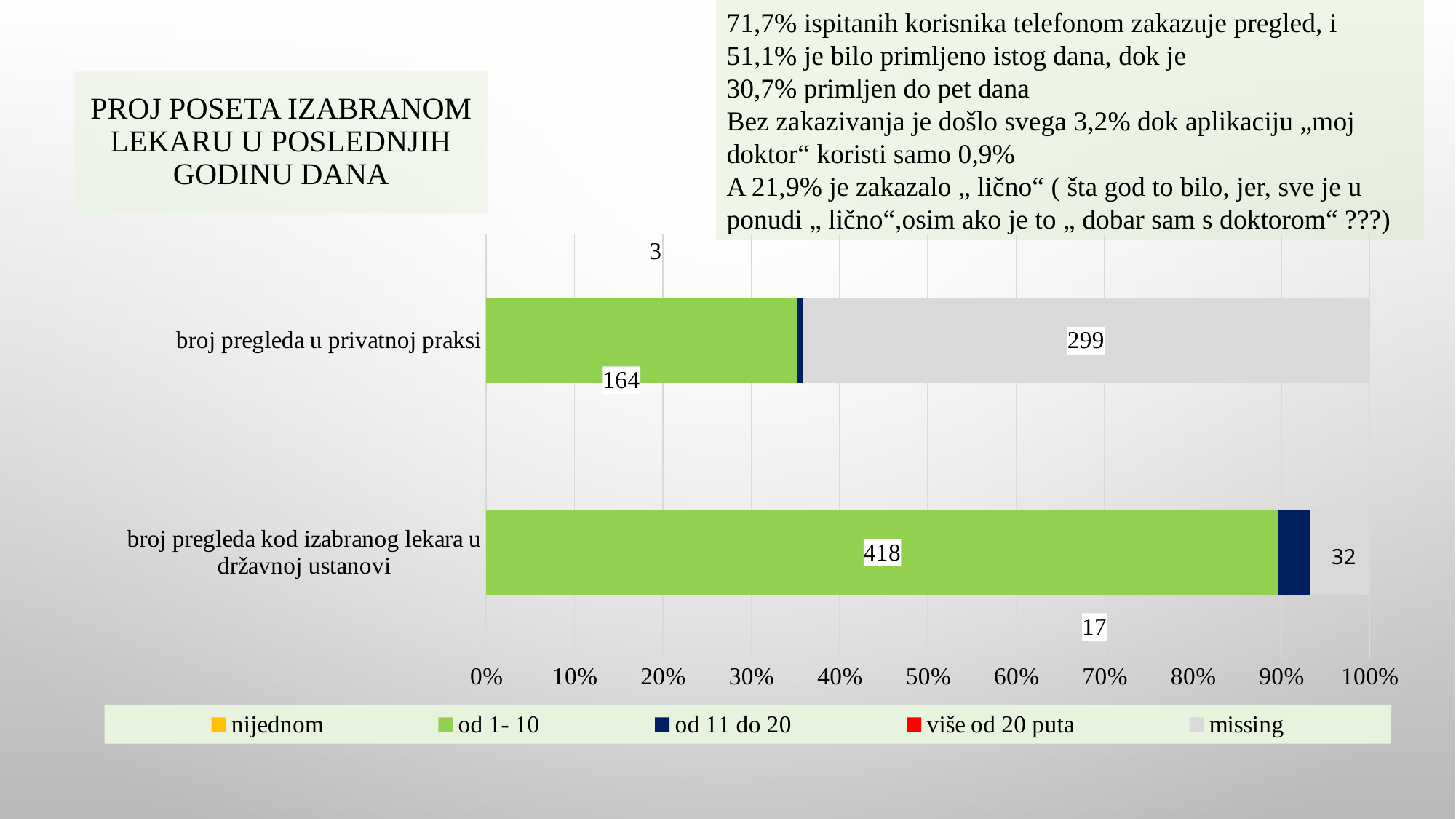
How many series does the chart legend list? 5 What is the value of the 'od 11 do 20' segment for 'broj pregleda kod izabranog lekara u državnoj ustanovi'? 17 What is the value of the 'missing' segment for 'broj pregleda u privatnoj praksi'? 299 What is the difference between the 'od 1- 10' values for 'broj pregleda kod izabranog lekara u državnoj ustanovi' and 'broj pregleda u privatnoj praksi'? 254 What is the value of the 'od 11 do 20' segment for 'broj pregleda u privatnoj praksi'? 3 What kind of chart is shown on the slide? stacked bar chart Is the share of the 'od 1- 10' segment in the 'broj pregleda u privatnoj praksi' bar greater or less than 40%? less Which category has the larger 'od 1- 10' value: 'broj pregleda u privatnoj praksi' or 'broj pregleda kod izabranog lekara u državnoj ustanovi'? broj pregleda kod izabranog lekara u državnoj ustanovi What is the value of the 'od 1- 10' segment for 'broj pregleda u privatnoj praksi'? 164 What is the value of the 'od 1- 10' segment for 'broj pregleda kod izabranog lekara u državnoj ustanovi'? 418 How many categories are plotted on the vertical axis of the chart? 2 What is the value of the 'missing' segment for 'broj pregleda kod izabranog lekara u državnoj ustanovi'? 32